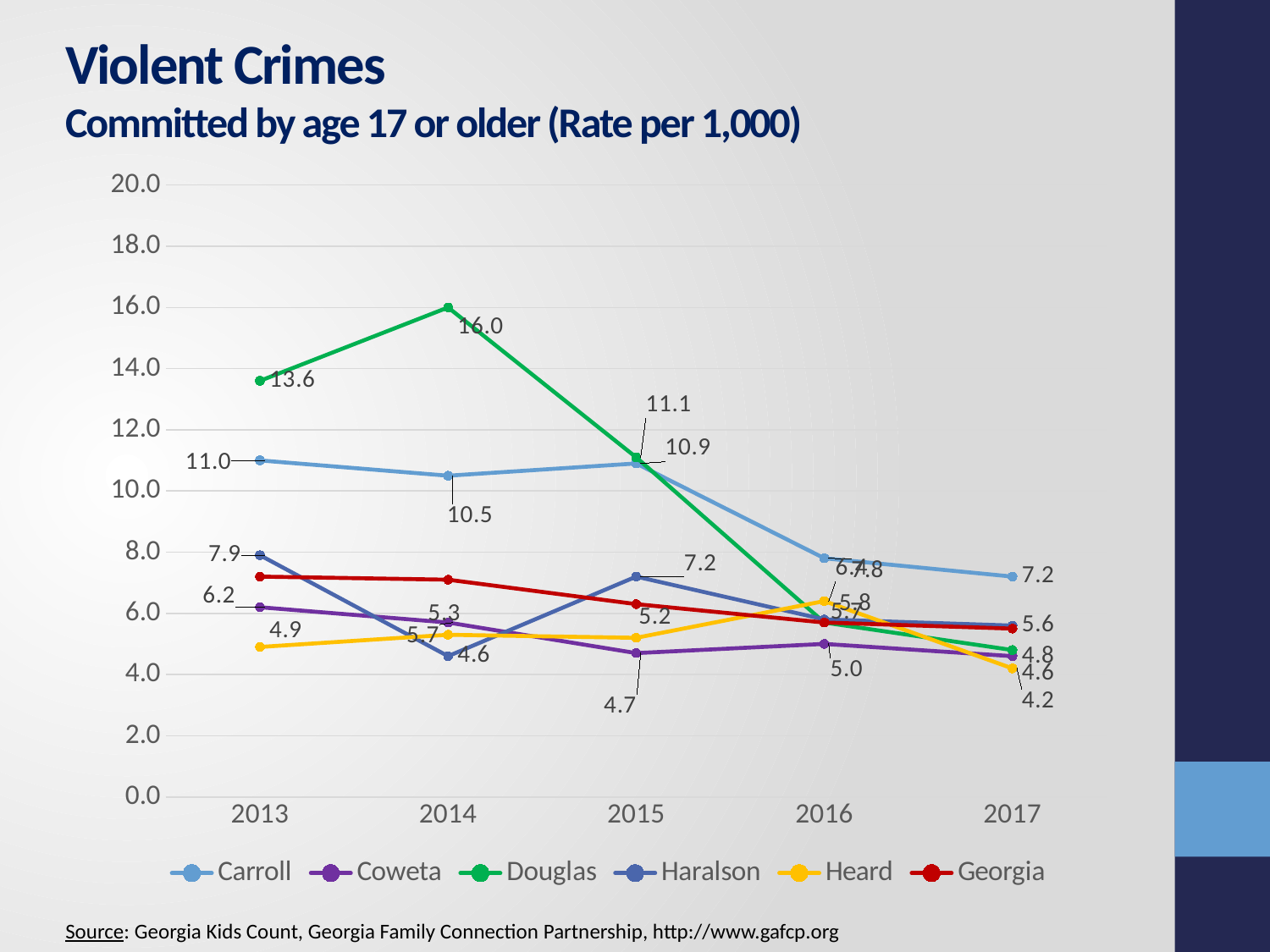
What is the value for Carroll in 2013? 11.0 Which series has the lowest value in 2017? Heard How many years are shown on the x axis? 5 What is the difference between the Carroll values in 2013 and 2017? 3.8 What kind of chart is shown on the slide? line chart How many series does the legend list? 6 What is the value for Haralson in 2014? 4.6 Which series has the highest value in 2014? Douglas What is the value for Douglas in 2014? 16.0 Does the Carroll line rise or fall from 2013 to 2017? fall By how much did the Douglas value increase from 2013 to 2014? 2.4 Is the value for Georgia in 2013 greater or less than 6.0? greater